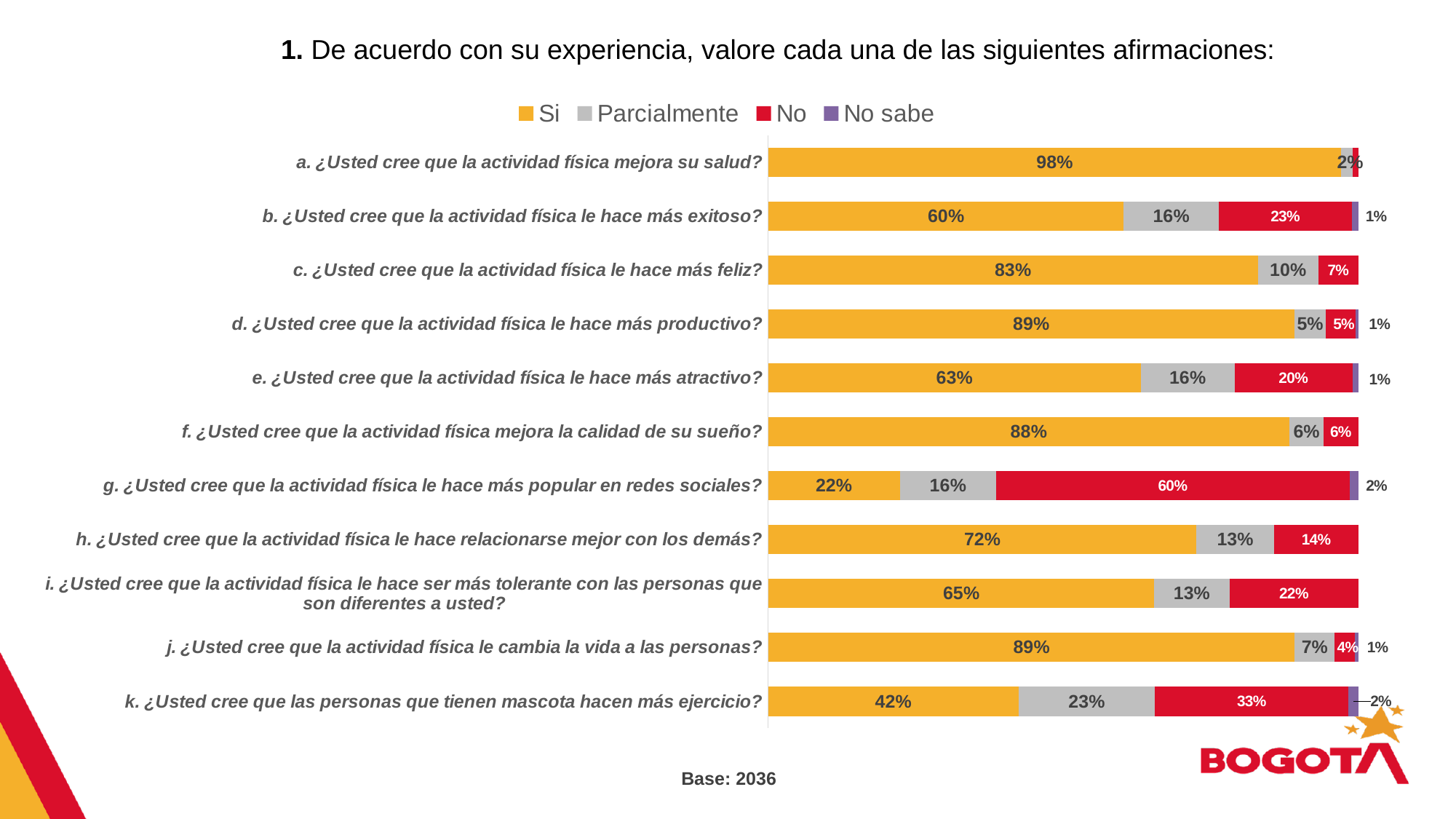
Which statement has the highest 'No' value? g. ¿Usted cree que la actividad física le hace más popular en redes sociales? (60%) What are the four legend entries of the chart? Si, Parcialmente, No, No sabe Which statement has the highest 'Si' value? a. ¿Usted cree que la actividad física mejora su salud? (98%) How many series does the legend list? 4 What is the 'Parcialmente' value for statement k (¿Usted cree que las personas que tienen mascota hacen más ejercicio?)? 23% What is the 'Si' value for statement g (¿Usted cree que la actividad física le hace más popular en redes sociales?)? 22% What kind of chart is shown on the slide? Stacked bar chart What is the 'No' value for statement k (¿Usted cree que las personas que tienen mascota hacen más ejercicio?)? 33% How many statements (categories) are plotted in the chart? 11 What is the difference between the 'Si' value for statement e (más atractivo) and statement b (más exitoso)? 3 percentage points Which statement has the lowest 'Si' value? g. ¿Usted cree que la actividad física le hace más popular en redes sociales? (22%) Which is larger: the 'No' value for statement g (más popular en redes sociales) or for statement k (personas que tienen mascota)? Statement g (60%)